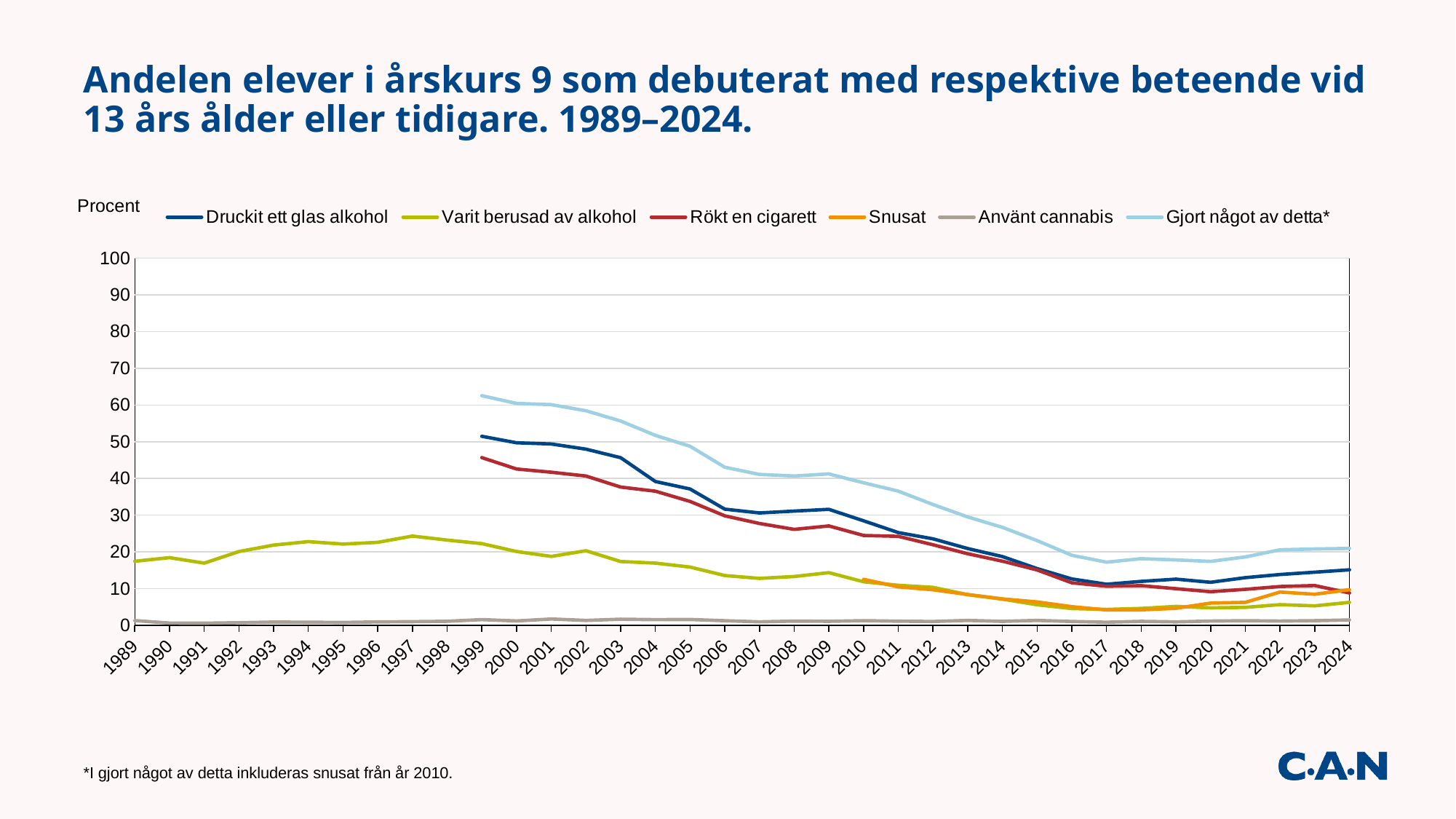
Which series has the highest value in 2010? Gjort något av detta* What is the label shown on the y axis? Procent Is the value for 'Använt cannabis' in 2024 greater or less than 10? less Does the value for 'Gjort något av detta*' rise or fall from 1999 to 2017? fall How many series does the legend list? 6 Is the value for 'Druckit ett glas alkohol' in 1999 greater or less than 40? greater Does the value for 'Varit berusad av alkohol' rise or fall from 1989 to 1997? rise Is the value for 'Gjort något av detta*' in 1999 greater or less than 50? greater How many years are shown on the x axis? 36 Which series has the lowest value in 2024? Använt cannabis In 2024, which is larger: 'Druckit ett glas alkohol' or 'Varit berusad av alkohol'? Druckit ett glas alkohol What kind of chart is shown on the slide? line chart